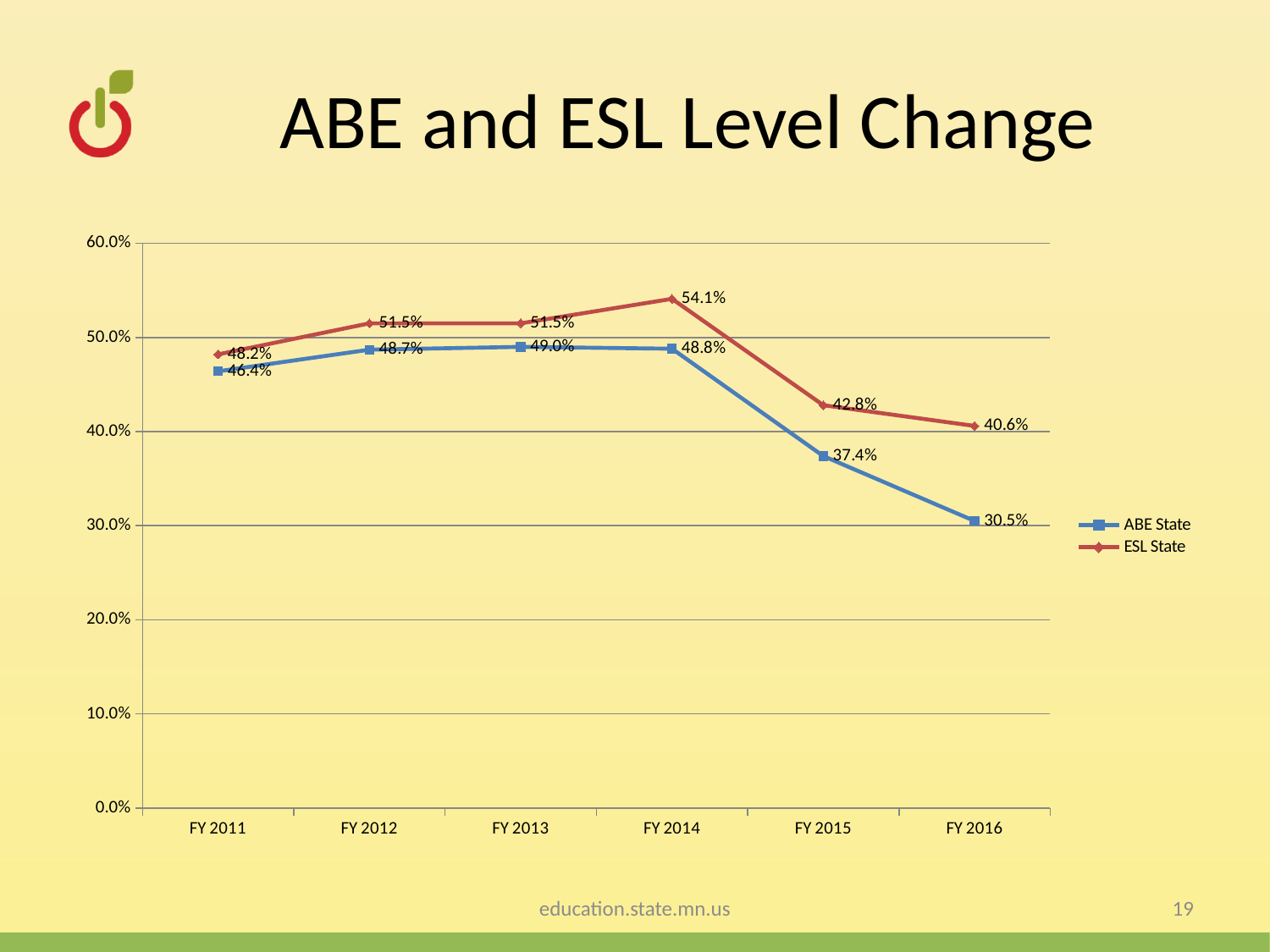
What is the ABE State value for FY 2011? 46.4% Does the ABE State value rise or fall from FY 2014 to FY 2016? Fall What is the ESL State value for FY 2014? 54.1% How many fiscal years are shown on the x axis? 6 What is the ABE State value for FY 2016? 30.5% What is the difference between the ESL State and ABE State values in FY 2016? 10.1% In which fiscal year is the ABE State value lowest? FY 2016 What is the ESL State value for FY 2015? 42.8% What kind of chart is shown on the slide? Line chart In which fiscal year is the ESL State value highest? FY 2014 How many series does the legend list? 2 Which series has the larger value in FY 2015, ABE State or ESL State? ESL State